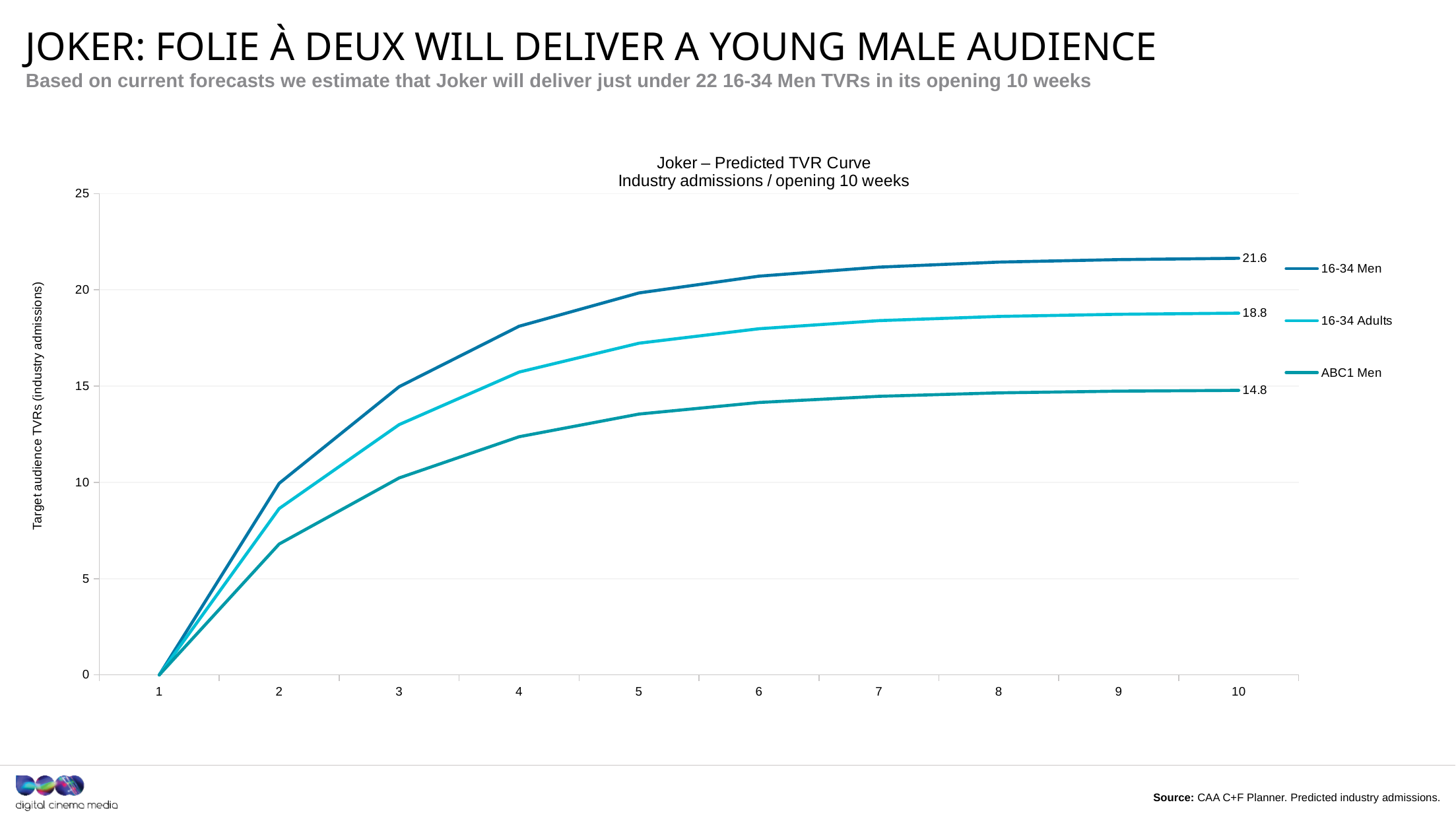
What is the value for 16-34 Adults at week 10? 18.8 Which series has the highest value at week 10? 16-34 Men What is the value for ABC1 Men at week 10? 14.8 What is the difference between the week 10 values for 16-34 Men and ABC1 Men? 6.8 How many series does the legend list? 3 Which series has the lowest value at week 10? ABC1 Men Is the value for 16-34 Men at week 2 greater or less than 5? greater What kind of chart is shown on the slide? Line chart What is the value for 16-34 Men at week 10? 21.6 Is the value for ABC1 Men at week 3 greater or less than 15? less What is the difference between the week 10 values for 16-34 Men and 16-34 Adults? 2.8 Which is larger at week 10: 16-34 Adults or ABC1 Men? 16-34 Adults